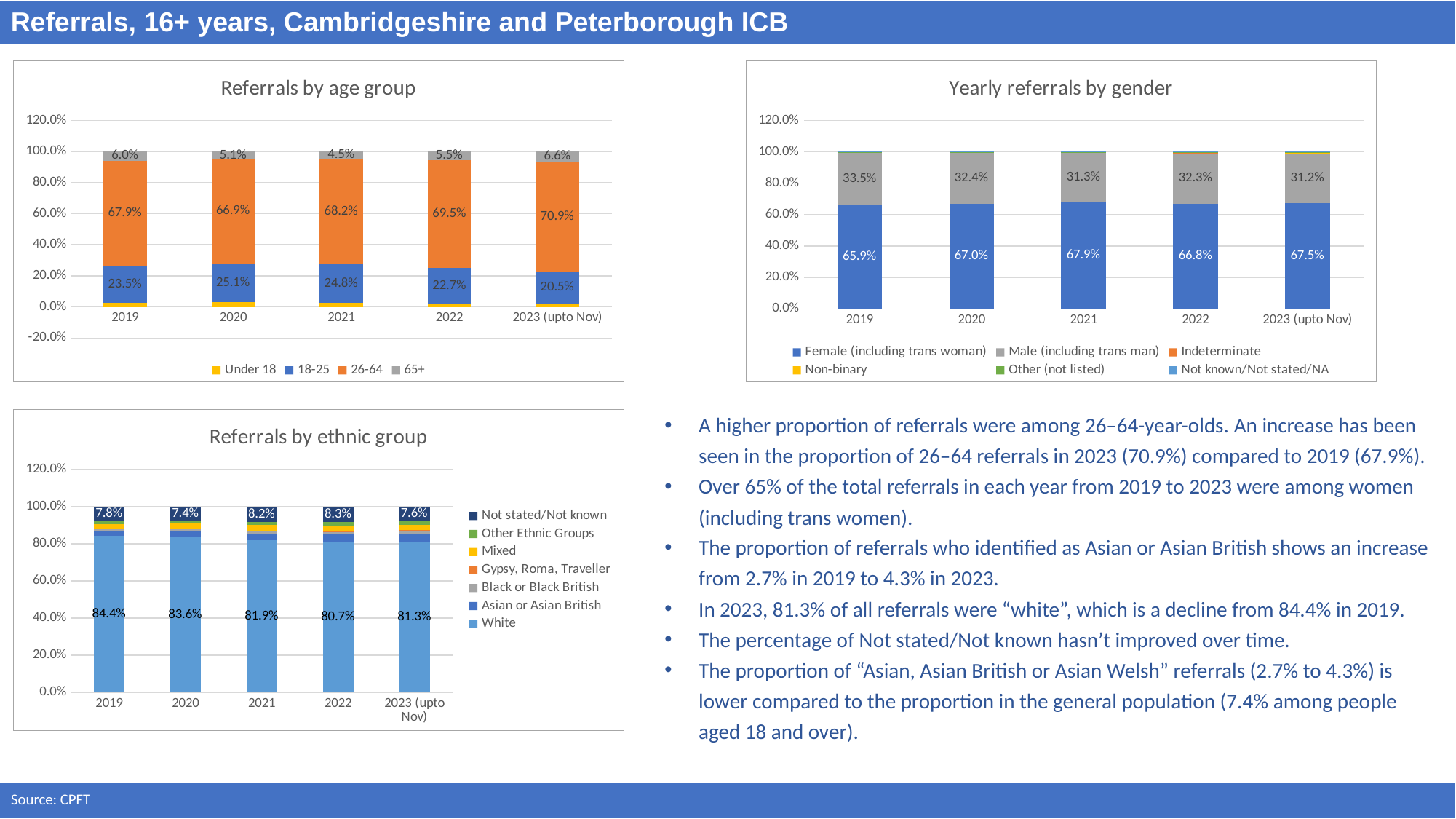
In the 'Referrals by age group' chart, which year has the highest value for 18-25? 2020 In the 'Yearly referrals by gender' chart, which year has the highest value for Male (including trans man)? 2019 In the 'Referrals by ethnic group' chart, what is the value for White in 2022? 80.7% In the 'Yearly referrals by gender' chart, what is the value for Female (including trans woman) in 2021? 67.9% How many series does the legend of the 'Referrals by age group' chart list? 4 In the 'Referrals by ethnic group' chart, which year has the highest value for Not stated/Not known? 2022 In the 'Referrals by age group' chart, which year has the lowest value for 65+? 2021 In the 'Referrals by age group' chart, what is the value for 26-64 in 2023 (upto Nov)? 70.9% In the 'Yearly referrals by gender' chart, is the Female (including trans woman) value in 2019 larger or smaller than in 2020? smaller What kind of chart is 'Referrals by ethnic group'? Stacked bar chart In the 'Referrals by age group' chart, what is the difference between the 26-64 value in 2023 (upto Nov) and in 2019? 3.0% How many series does the legend of the 'Yearly referrals by gender' chart list? 6